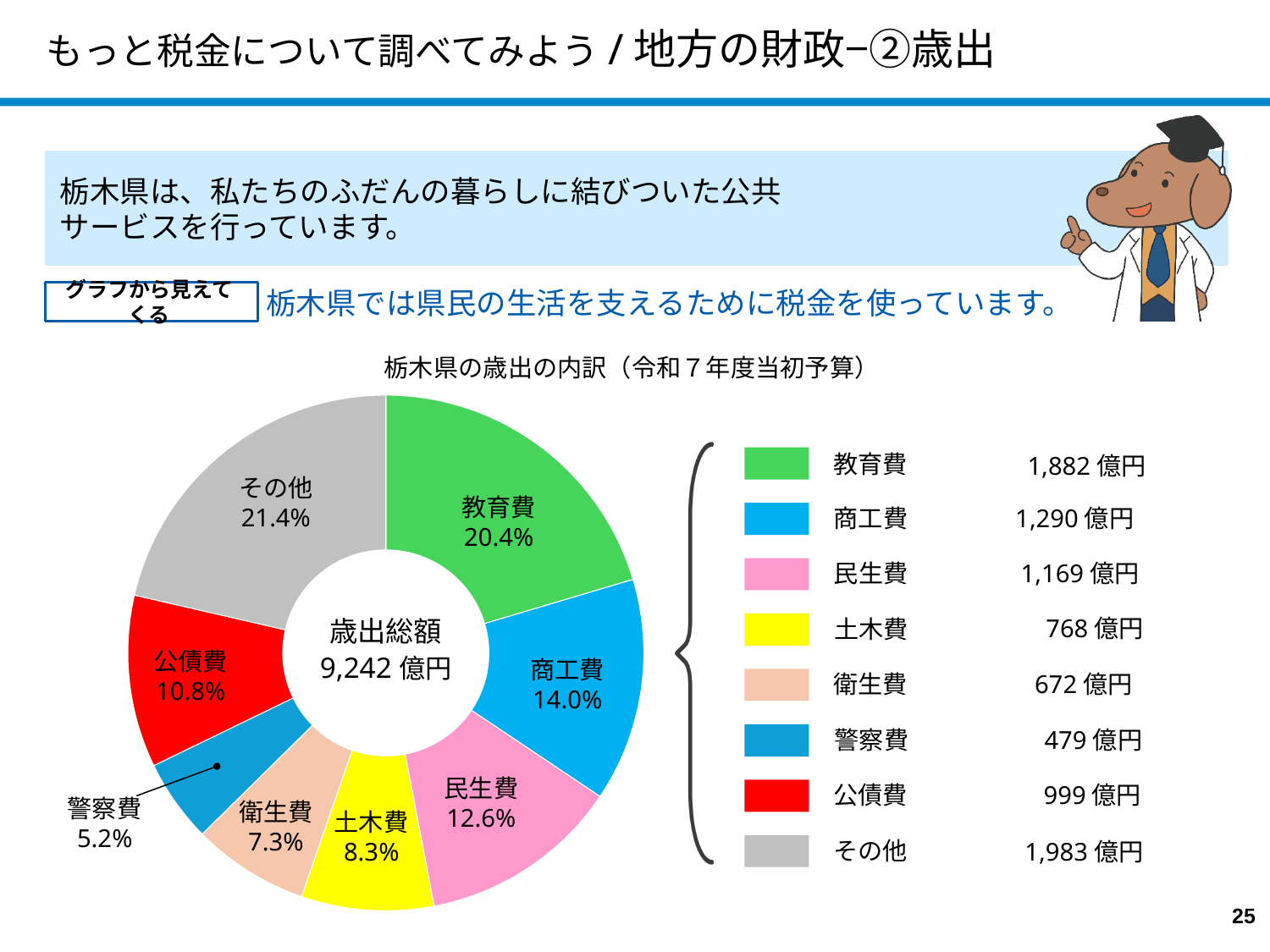
What type of chart is shown on the slide? pie chart (donut) What is the title of the chart? 栃木県の歳出の内訳（令和７年度当初予算） How many categories are shown in the pie chart? 8 What colour is the 土木費 slice? yellow What is the amount shown for 警察費? 479 億円 Which category has the smallest share of the pie? 警察費 What share of the pie does 教育費 represent? 20.4% What is the difference in amount between 教育費 and 民生費? 713 億円 Which category has the largest share of the pie? その他 Which is larger, the share for 公債費 or the share for 土木費? 公債費 What is the total expenditure (歳出総額) shown in the centre of the chart? 9,242 億円 What is the amount shown for 商工費 in the legend? 1,290 億円